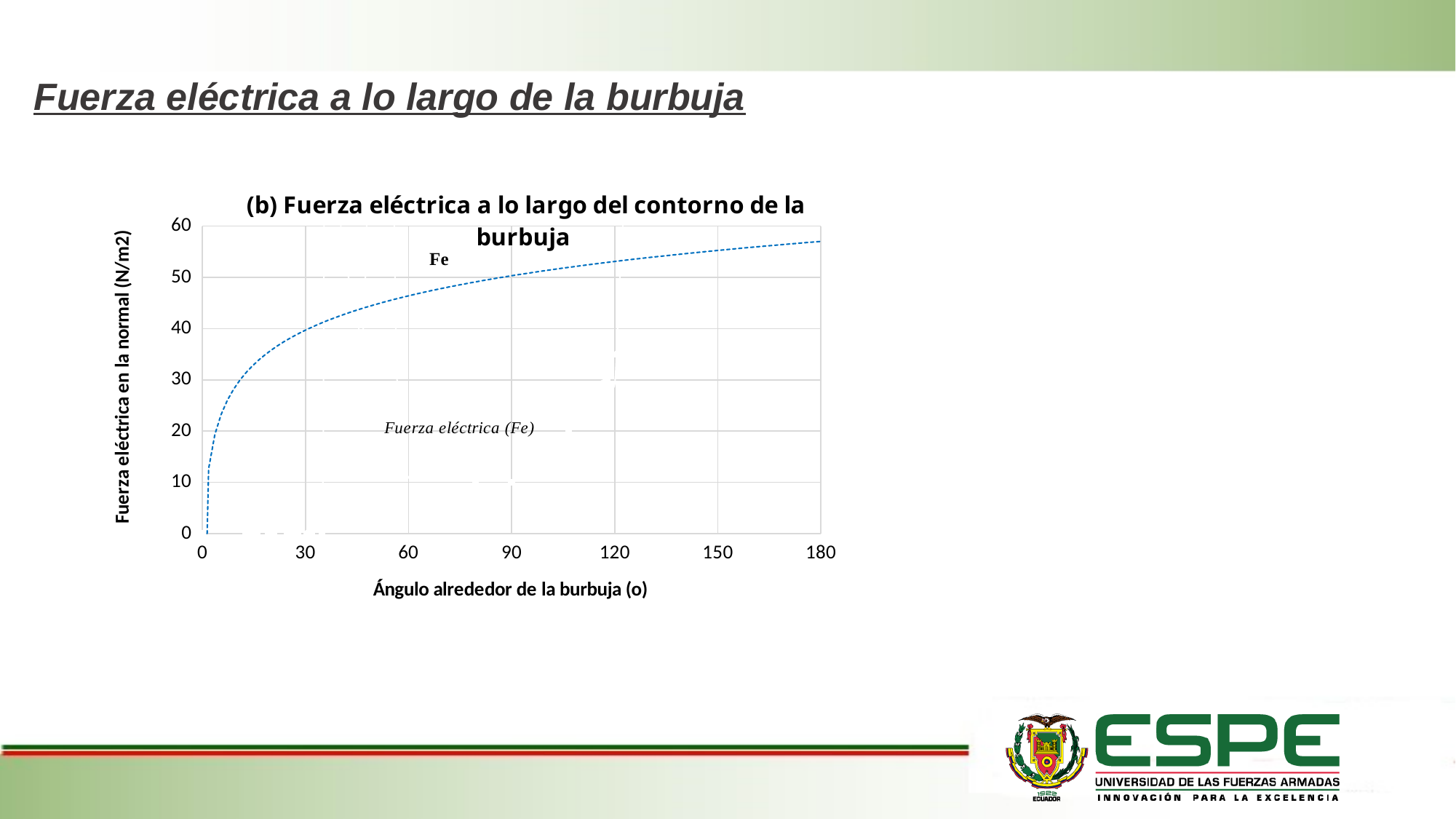
Is the value of the electric force at an angle of 150 greater or less than 50? greater At which angle on the x axis does the electric force reach its highest value? 180 Is the value of the electric force at an angle of 60 greater or less than 40? greater Is the value of the electric force at an angle of 60 greater or less than 50? less Is the electric force larger at an angle of 30 or at an angle of 150? 150 What is the title of the chart? (b) Fuerza eléctrica a lo largo del contorno de la burbuja What is the label of the x axis of the chart? Ángulo alrededor de la burbuja (o) Does the electric force rise or fall as the angle around the bubble increases from 0 to 180? rises What kind of chart is shown on the slide? line chart